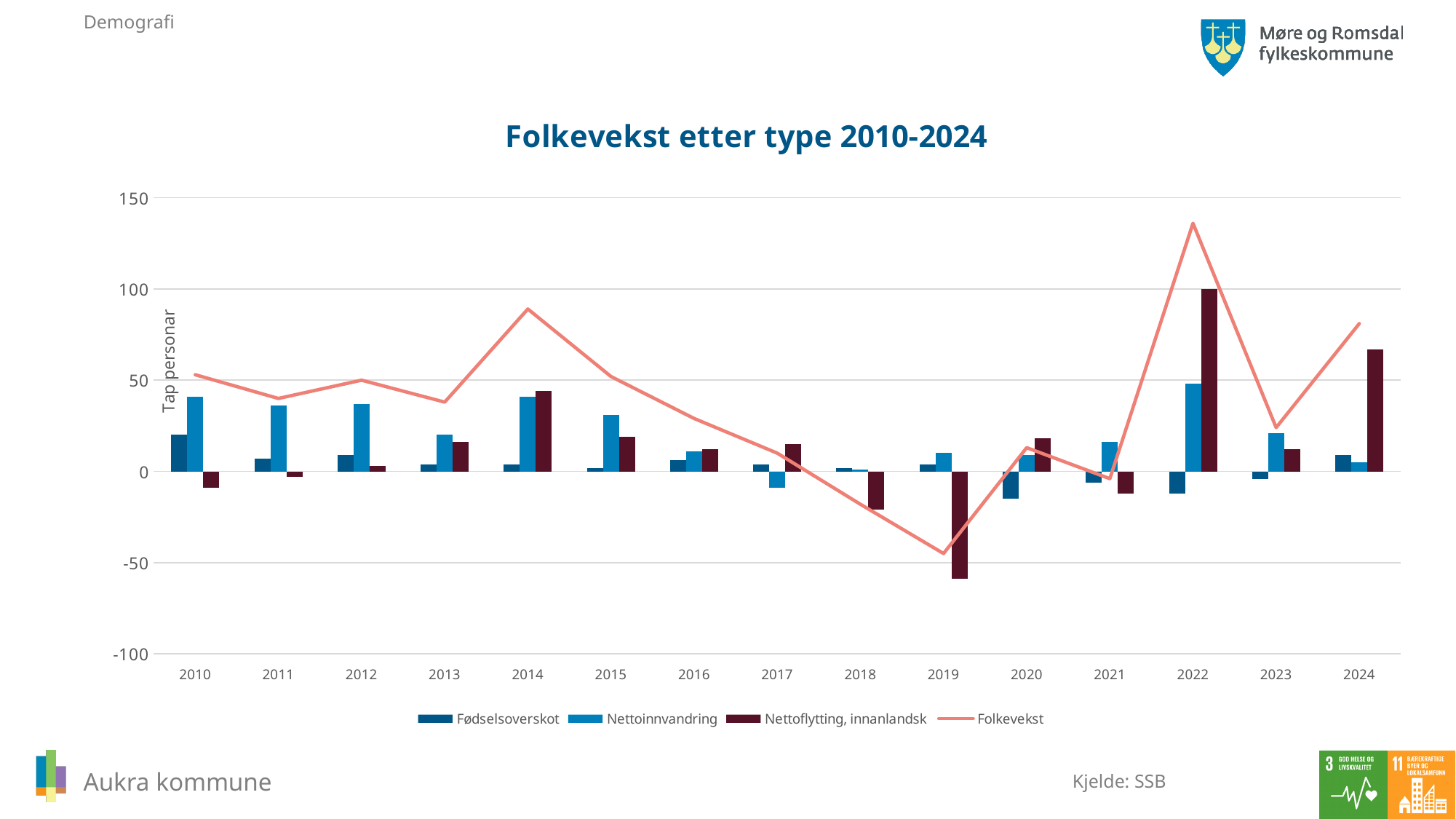
Is the Nettoflytting, innanlandsk value for 2019 greater or less than -50? less What kind of chart is this? Combined bar and line chart How many series does the legend list? 4 How many years are shown on the x axis? 15 Does the Folkevekst line rise or fall from 2014 to 2019? fall In which year is the Nettoflytting, innanlandsk bar the lowest? 2019 In which year is the Nettoflytting, innanlandsk bar the highest? 2022 In 2022, which is larger: Nettoflytting, innanlandsk or Nettoinnvandring? Nettoflytting, innanlandsk What is the title of the chart? Folkevekst etter type 2010-2024 In which year does the Folkevekst line reach its lowest value? 2019 In which year does the Folkevekst line reach its highest value? 2022 Is the Folkevekst value for 2022 greater or less than 100? greater